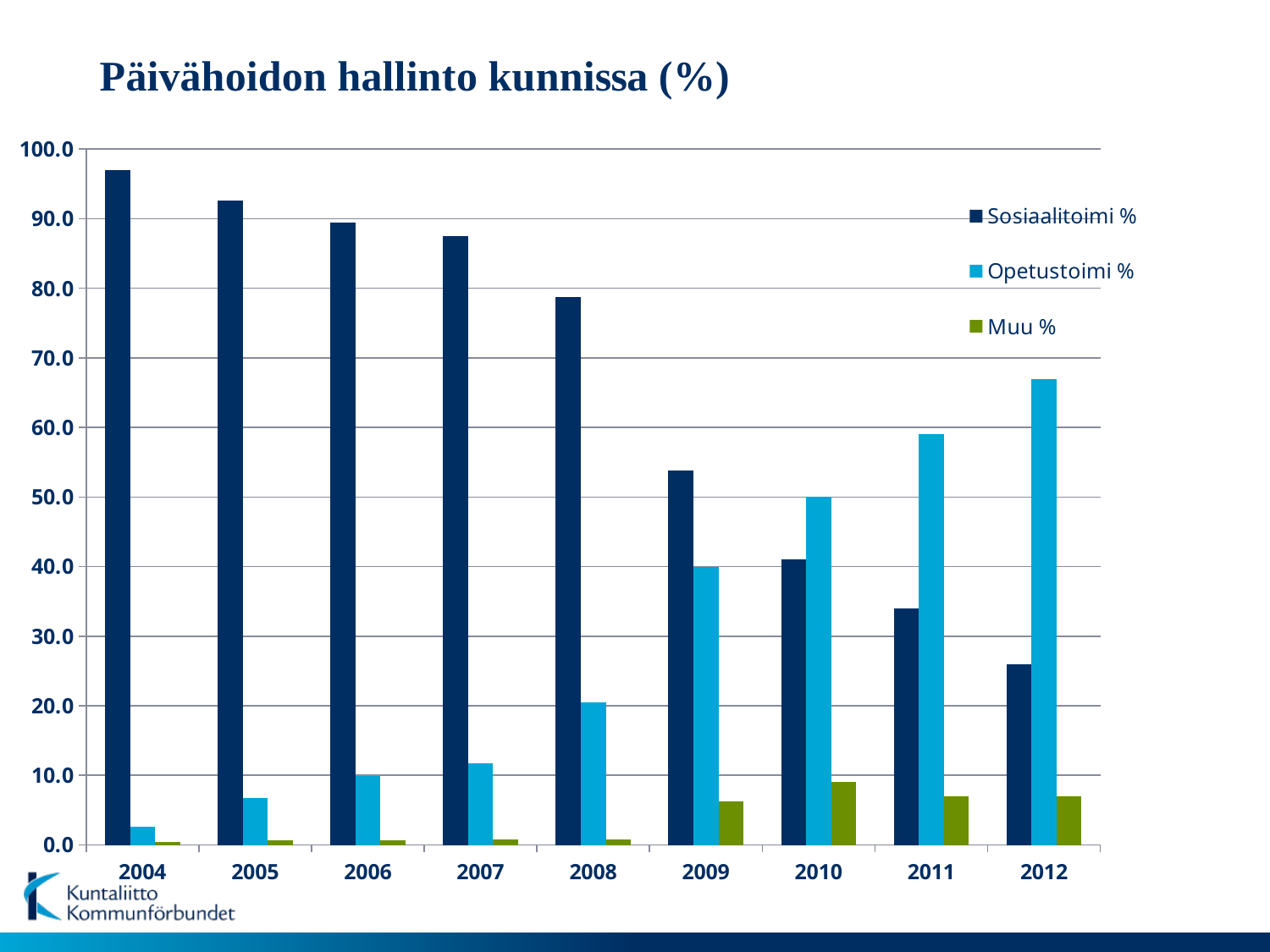
How many years are shown on the x axis? 9 Which year has the highest value for Opetustoimi %? 2012 Is the value for Opetustoimi % in 2011 greater or less than 50.0? greater Which year has the lowest value for Sosiaalitoimi %? 2012 What kind of chart is shown on the slide? bar chart How many series does the legend list? 3 Which year has the lowest value for Opetustoimi %? 2004 Is the value for Sosiaalitoimi % in 2008 greater or less than 70.0? greater Which year has the highest value for Sosiaalitoimi %? 2004 Does the value for Sosiaalitoimi % rise or fall from 2004 to 2012? fall In 2012, which is larger: Sosiaalitoimi % or Opetustoimi %? Opetustoimi % In 2009, which is larger: Sosiaalitoimi % or Opetustoimi %? Sosiaalitoimi %